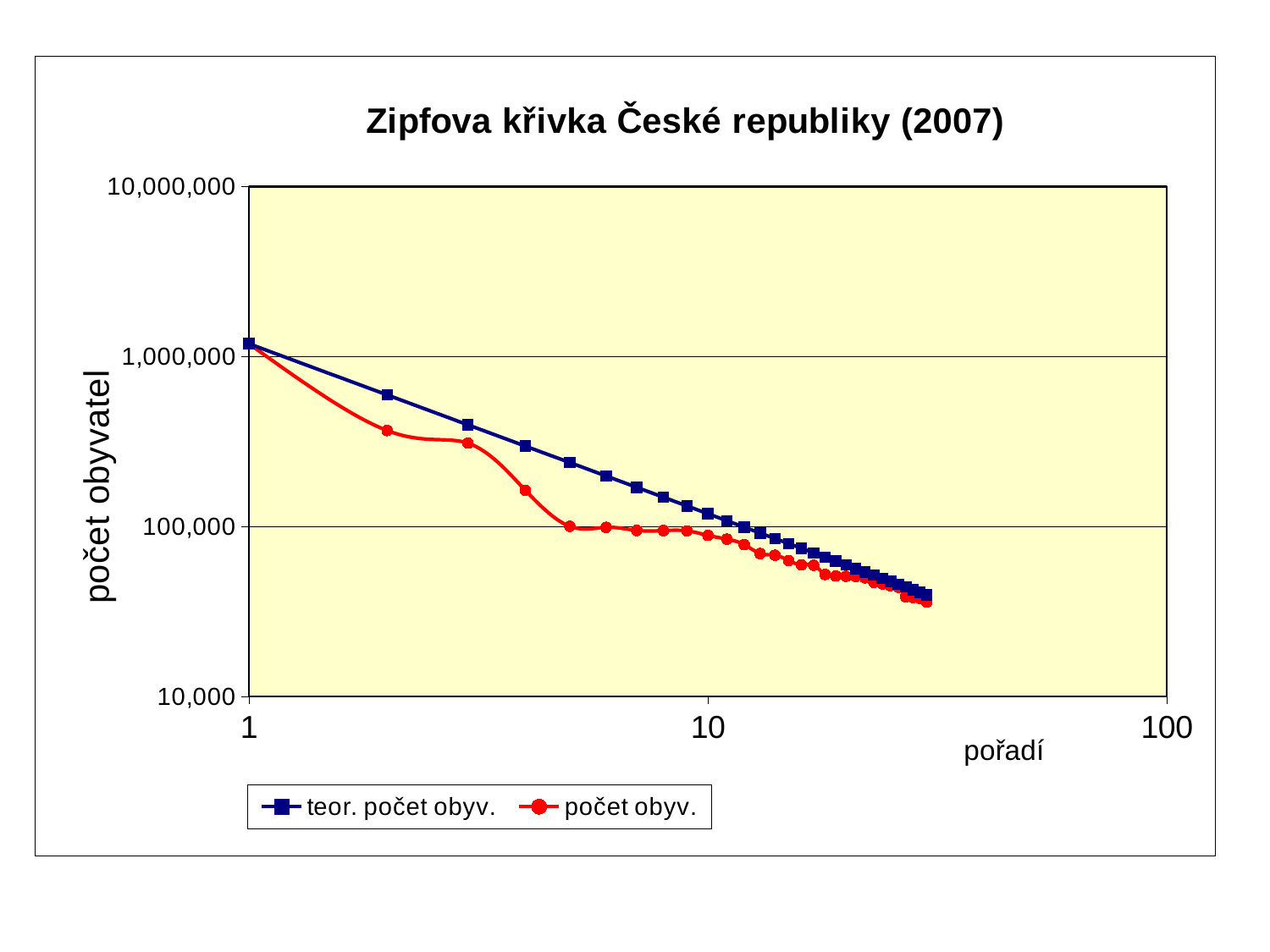
Is the value of 'počet obyv.' at pořadí 4 greater or less than 100,000? greater Do the values of the 'počet obyv.' series rise or fall as pořadí increases? fall What is the title of the chart? Zipfova křivka České republiky (2007) At pořadí 2, which series has the higher value, 'teor. počet obyv.' or 'počet obyv.'? teor. počet obyv. Do the values of the 'teor. počet obyv.' series rise or fall as pořadí increases? fall Is the value of 'počet obyv.' at pořadí 2 greater or less than 1,000,000? less Is the value of 'počet obyv.' at pořadí 1 greater or less than 10,000,000? less How many series does the legend list? 2 What kind of chart is shown on the slide? line chart At pořadí 4, which series has the higher value, 'teor. počet obyv.' or 'počet obyv.'? teor. počet obyv. What is the label of the y axis? počet obyvatel